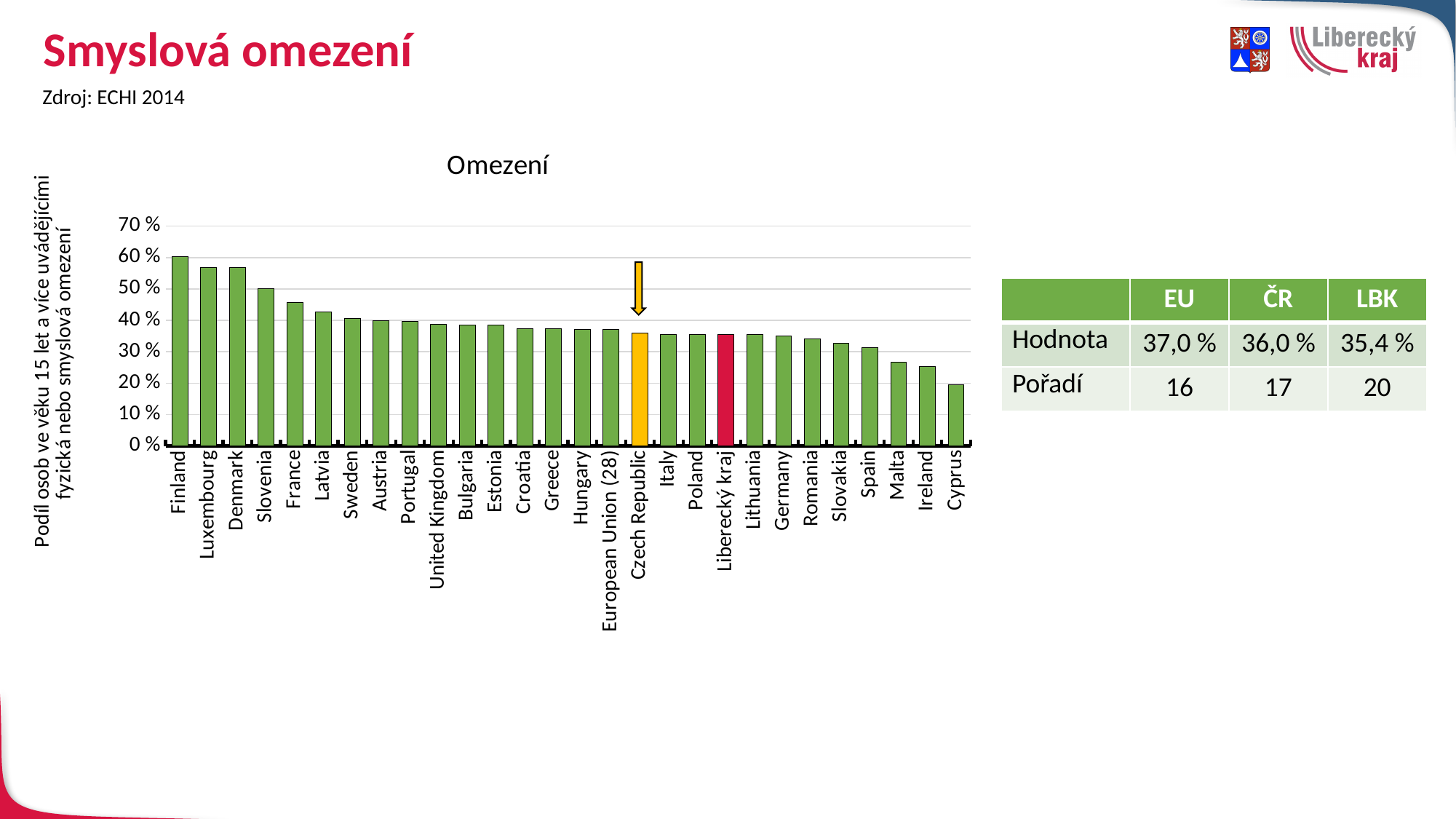
Which category has the highest value in the chart? Finland According to the table next to the chart, what is the value for the Czech Republic (ČR)? 36,0 % What colour is the bar for Liberecký kraj? red Which has the larger value, Denmark or Slovenia? Denmark Do the values rise or fall from left to right along the x axis? fall Is the value for France greater or less than 40 %? greater What is the title of the chart? Omezení How many countries/regions are plotted in the chart? 28 Is the value for Cyprus greater or less than 30 %? less Which category has the lowest value in the chart? Cyprus What kind of chart is shown on the slide? bar chart Is the value for Finland greater or less than 50 %? greater